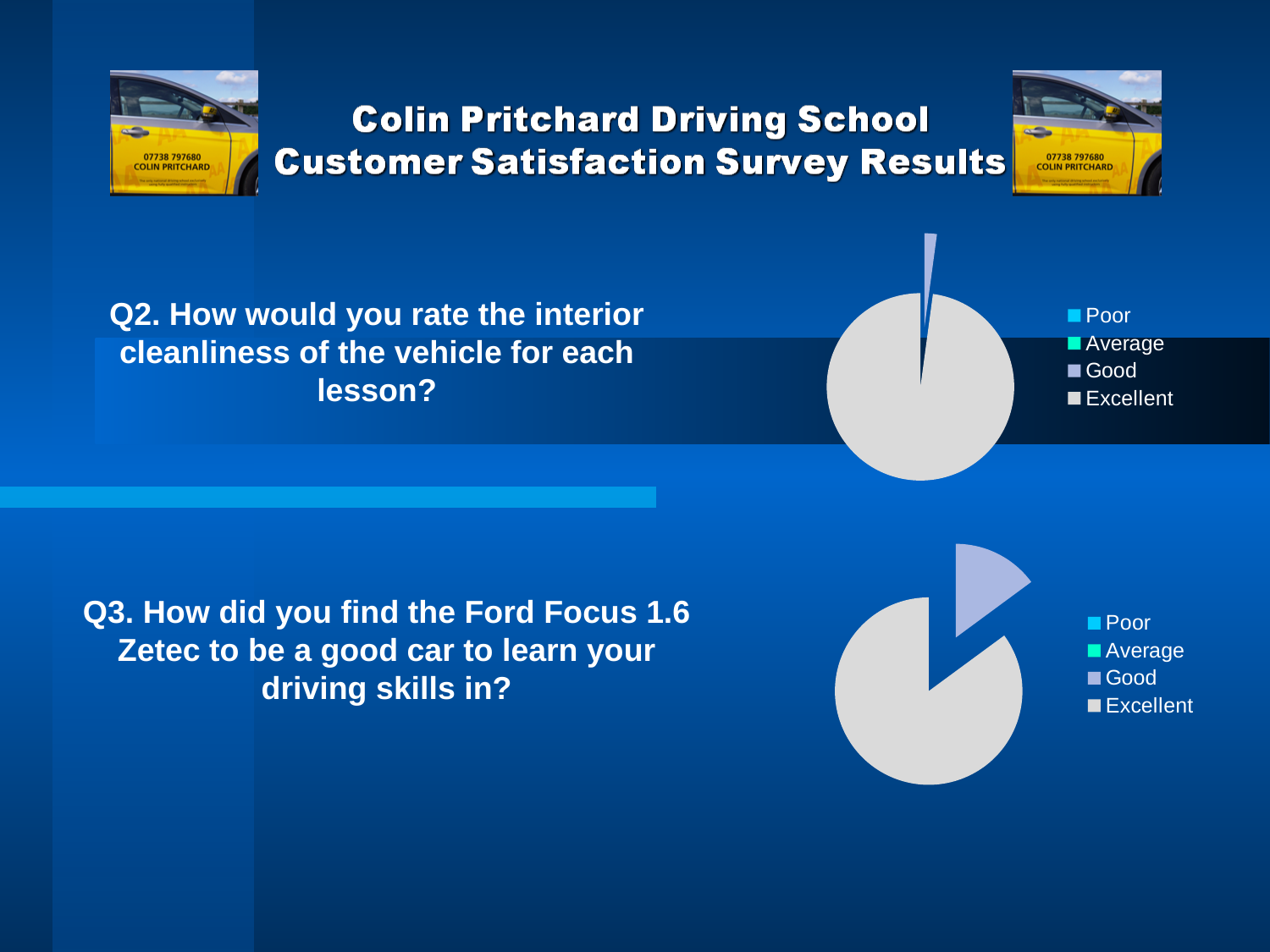
Which chart has the larger Good slice, the top chart (Q2) or the bottom chart (Q3)? The bottom chart (Q3) In the bottom chart (Q3, Ford Focus 1.6 Zetec), which category has the largest slice? Excellent In the top chart (Q2, interior cleanliness), which slice is larger, Excellent or Good? Excellent In the bottom chart (Q3, Ford Focus 1.6 Zetec), which slice is larger, Good or Excellent? Excellent In the bottom chart (Q3, Ford Focus 1.6 Zetec), which category is shown in grey? Excellent What are the legend entries of the top chart (Q2, interior cleanliness), in order? Poor, Average, Good, Excellent In the bottom chart (Q3, Ford Focus 1.6 Zetec), how many categories does the legend list? 4 In the top chart (Q2, interior cleanliness), which category has the largest slice? Excellent In the top chart (Q2, interior cleanliness), how many categories does the legend list? 4 What kind of chart is shown next to Q3 (the bottom chart)? Pie chart What kind of chart is shown next to Q2 (the top chart)? Pie chart